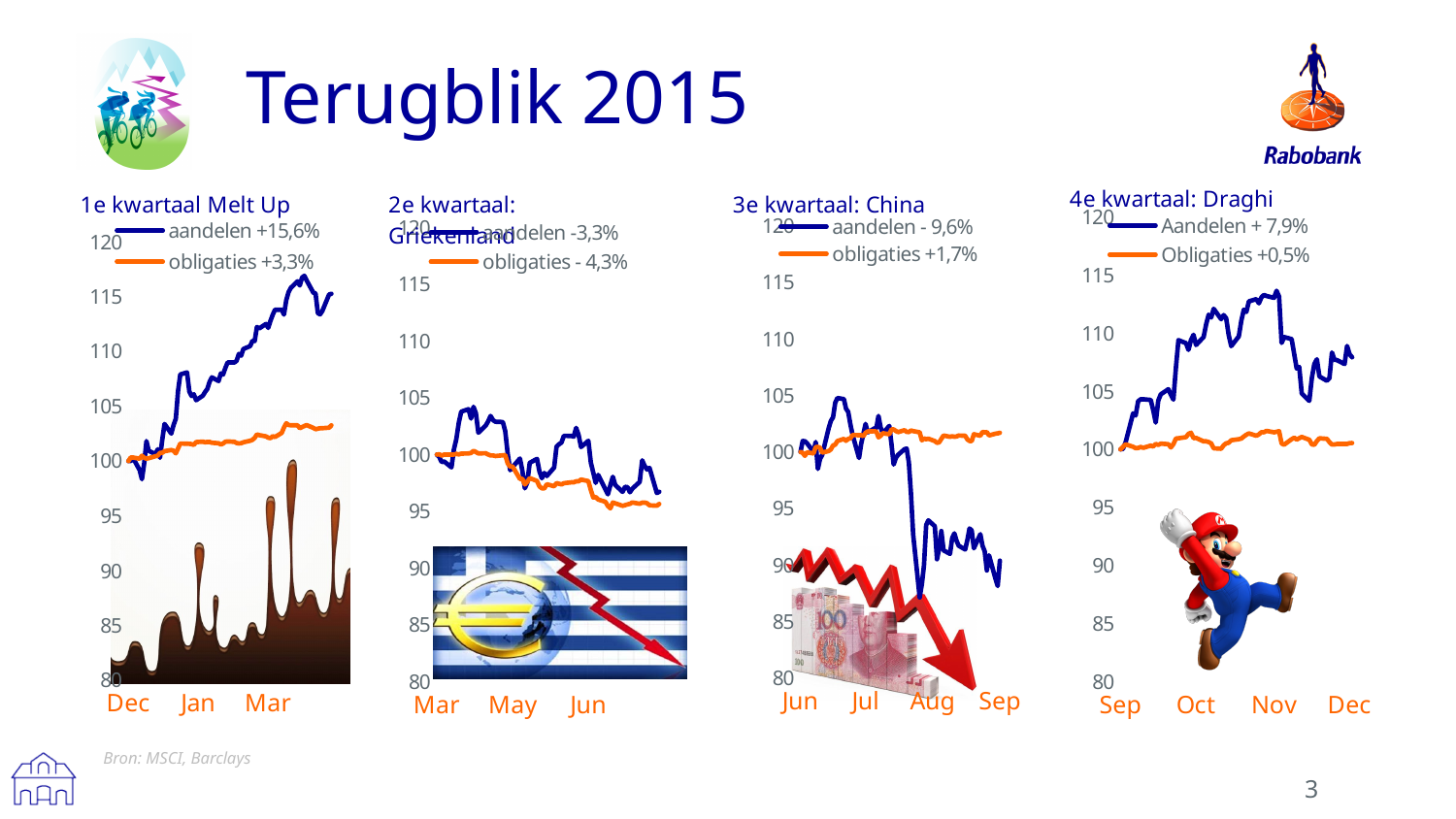
How many charts are shown on the slide? 4 In the '1e kwartaal Melt Up' chart, does the aandelen line generally rise or fall from Dec to Mar? rise In the '1e kwartaal Melt Up' chart, what percentage change is shown in the legend entry for aandelen? +15,6% What kind of chart is the '1e kwartaal Melt Up' chart? line chart How many series does the legend of the '3e kwartaal: China' chart list? 2 In the '4e kwartaal: Draghi' chart, is the final value of the Aandelen line greater or less than 105? greater In the '3e kwartaal: China' chart, does the aandelen line generally rise or fall from Jun to Sep? fall In the '2e kwartaal: Griekenland' chart, is the final value of the obligaties line greater or less than 100? less In the '1e kwartaal Melt Up' chart, is the final value of the aandelen line greater or less than 110? greater In the '4e kwartaal: Draghi' chart, what percentage change is shown in the legend entry for Obligaties? +0,5% In the '4e kwartaal: Draghi' chart, which series ends higher at Dec, Aandelen or Obligaties? Aandelen